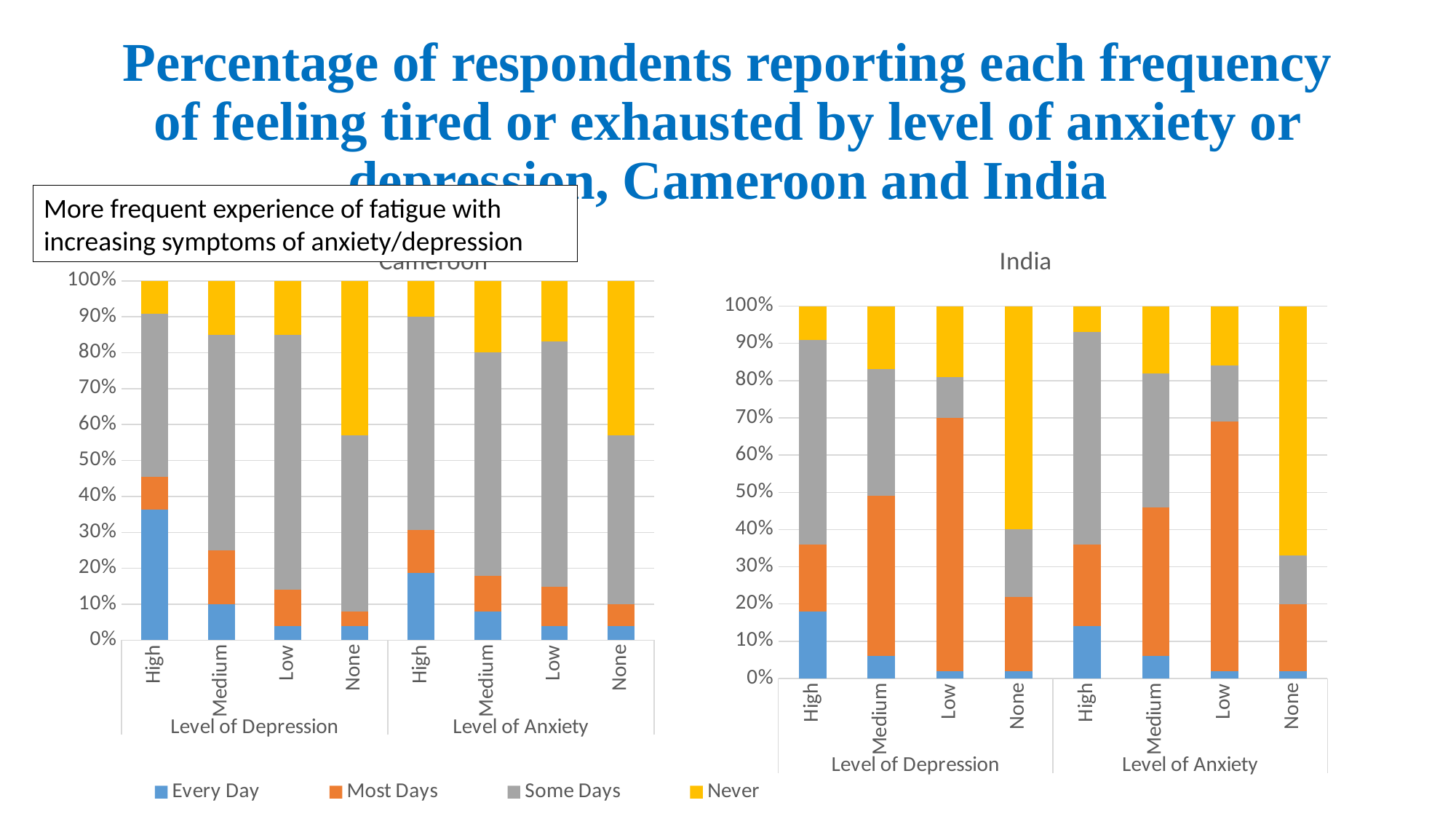
In the Cameroon chart, does the Every Day share rise or fall going from High to None under Level of Depression? fall In the Cameroon chart, which has the larger Every Day share: High under Level of Depression or High under Level of Anxiety? High under Level of Depression In the India chart, is the Never share for None under Level of Depression greater or less than 50%? greater What kind of chart is the Cameroon chart? stacked bar chart In the Cameroon chart, is the Every Day share for High under Level of Depression greater or less than 30%? greater In the India chart, which has the larger Most Days share: Low or Medium under Level of Depression? Low In the India chart, does the Never share rise or fall going from High to None under Level of Anxiety? rise In the India chart, is the Every Day share for Low under Level of Anxiety greater or less than 10%? less How many series does the legend list? 4 Which legend entry is shown in yellow? Never How many bars are plotted in the India chart? 8 What is the title of the chart on the right? India